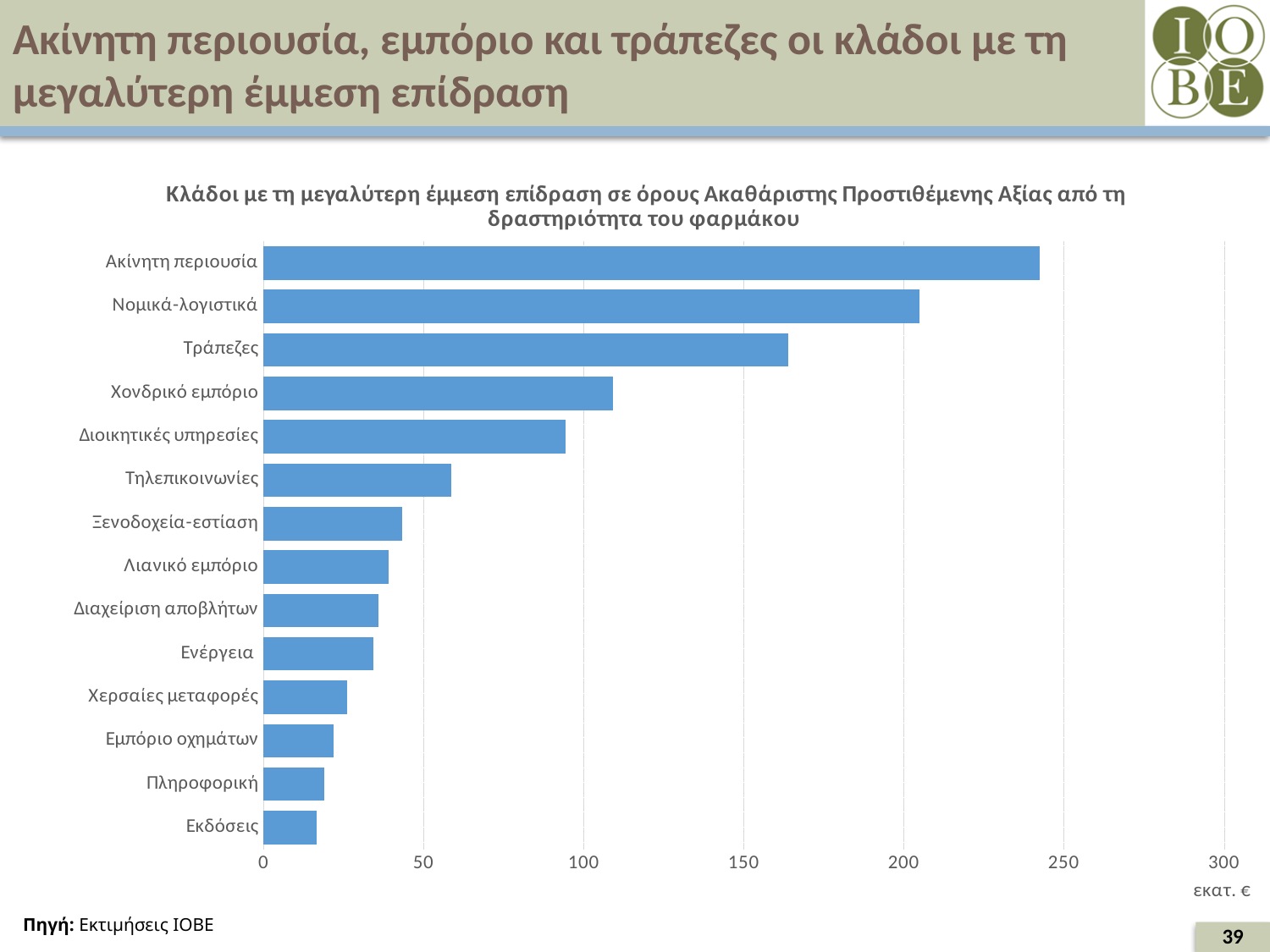
How many sectors (categories) are plotted in the chart? 14 Is the value for Τηλεπικοινωνίες greater or less than 50? greater Which has the larger value, Πληροφορική or Χερσαίες μεταφορές? Χερσαίες μεταφορές Which has the larger value, Νομικά-λογιστικά or Τράπεζες? Νομικά-λογιστικά Which sector has the lowest value in the chart? Εκδόσεις Is the value for Ακίνητη περιουσία greater or less than 200? greater What unit is shown for the values on the x axis of the chart? εκατ. € Is the value for Τράπεζες greater or less than 150? greater What kind of chart is shown on the slide? Bar chart Which sector has the highest value in the chart? Ακίνητη περιουσία